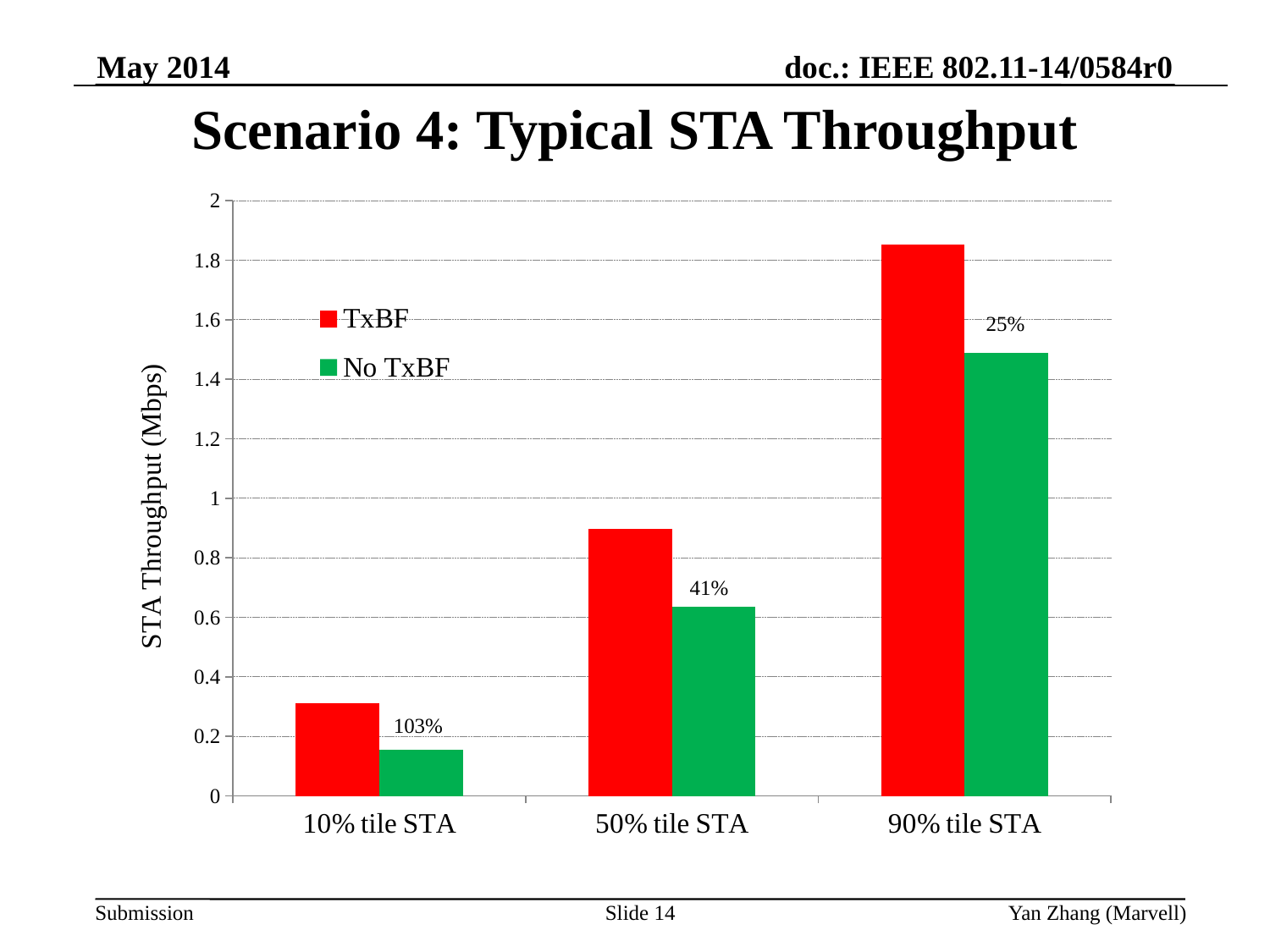
Which category has the highest TxBF throughput? 90% tile STA How many categories are shown on the x axis? 3 Is the No TxBF value for the 10% tile STA greater or less than 0.2? less Which category has the lowest No TxBF throughput? 10% tile STA What percentage label is printed above the 10% tile STA bars? 103% Do the TxBF values rise or fall from the 10% tile STA to the 90% tile STA? rise What kind of chart is shown on the slide? bar chart For the 50% tile STA, which series has the larger value, TxBF or No TxBF? TxBF Is the TxBF value for the 90% tile STA greater or less than 1.6? greater Is the No TxBF value for the 50% tile STA greater or less than 0.8? less How many series does the legend list? 2